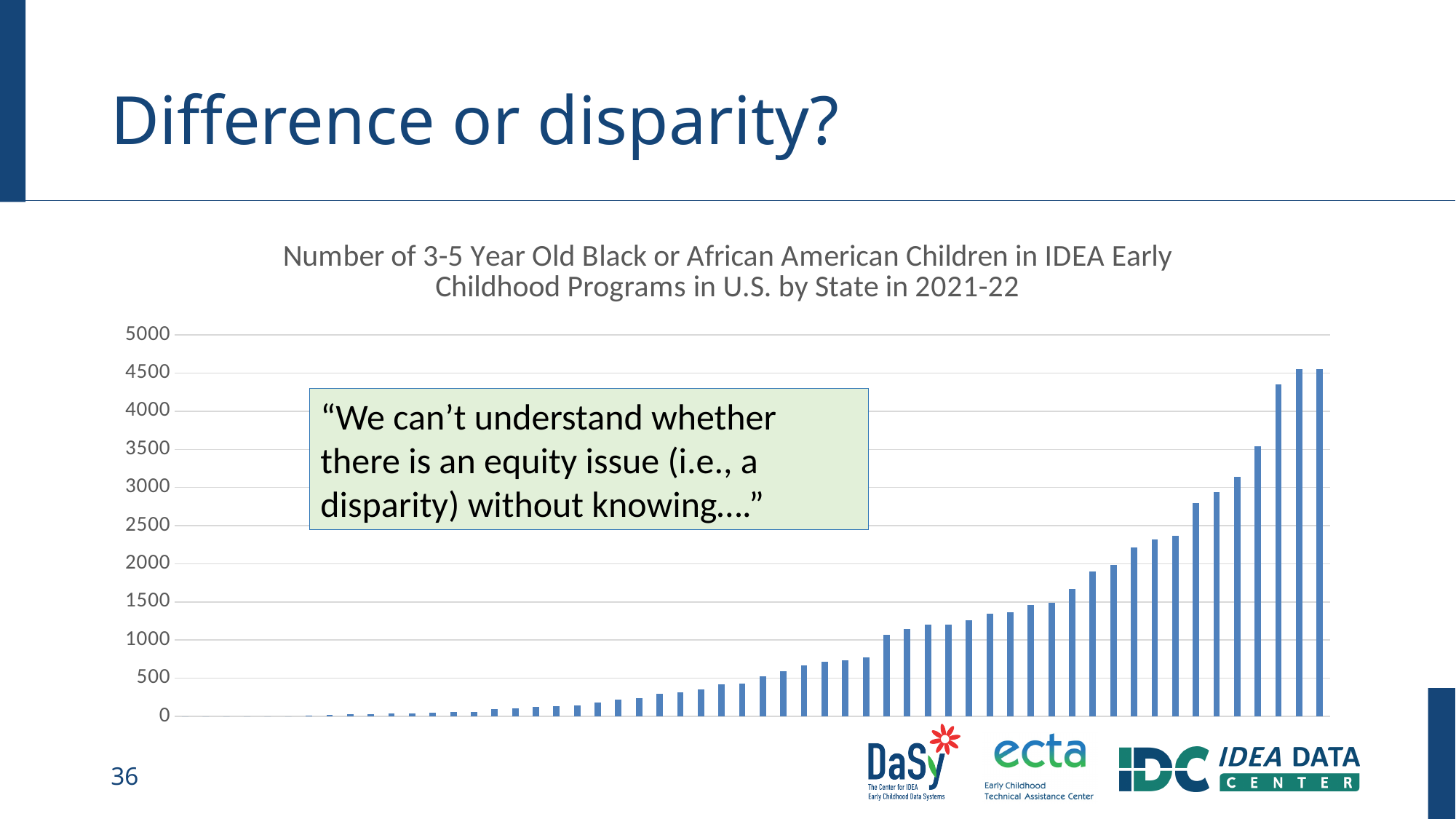
Which school year does the chart's data cover? 2021-22 Do the bar values rise or fall from left to right across the chart? Rise Is the value of the leftmost bar greater or less than 500? less Is the value of the tallest bar greater or less than 4000? greater Is the value of the tallest bar greater or less than 5000? less What is the highest value shown on the vertical axis? 5000 What is the title of the chart? Number of 3-5 Year Old Black or African American Children in IDEA Early Childhood Programs in U.S. by State in 2021-22 What kind of chart is shown on the slide? Bar chart